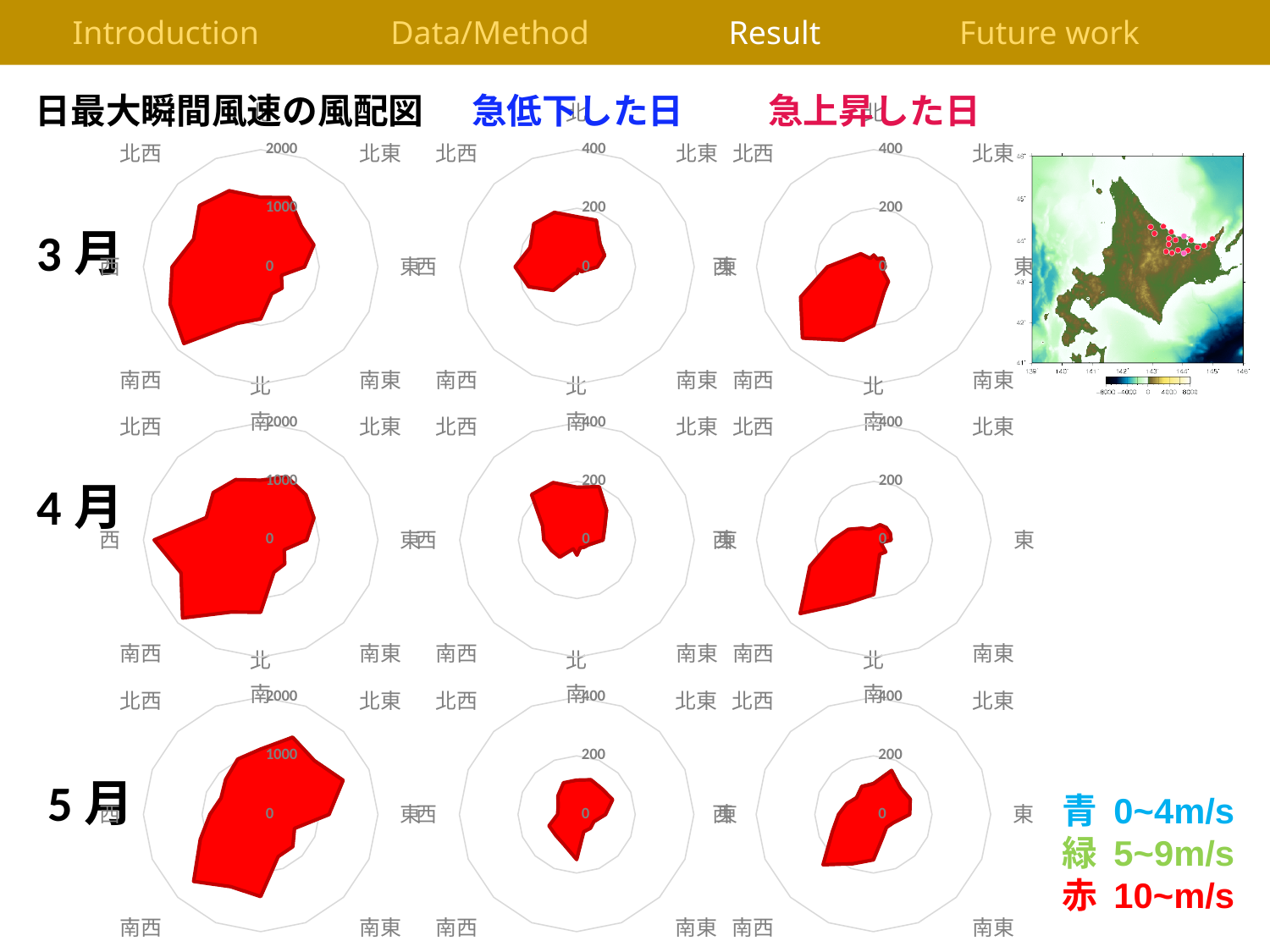
What is the outermost axis value on the 急低下した日 and 急上昇した日 charts? 400 In the 5月 急上昇した日 chart (right column, bottom row), is the value for 南西 greater or less than 200? greater In the 5月 急低下した日 chart (middle column, bottom row), is the value for 南西 greater or less than 200? less In the 3月 日最大瞬間風速の風配図 chart (left column, top row), is the value for 北西 greater or less than 1000? greater What kind of chart is used for the 3月 日最大瞬間風速の風配図 (left column, top row)? radar chart How many wind rose charts are shown on the slide in total? 9 How many wind-direction categories does each wind rose chart on the slide have? 8 What is the outermost axis value on the 日最大瞬間風速の風配図 charts in the left column? 2000